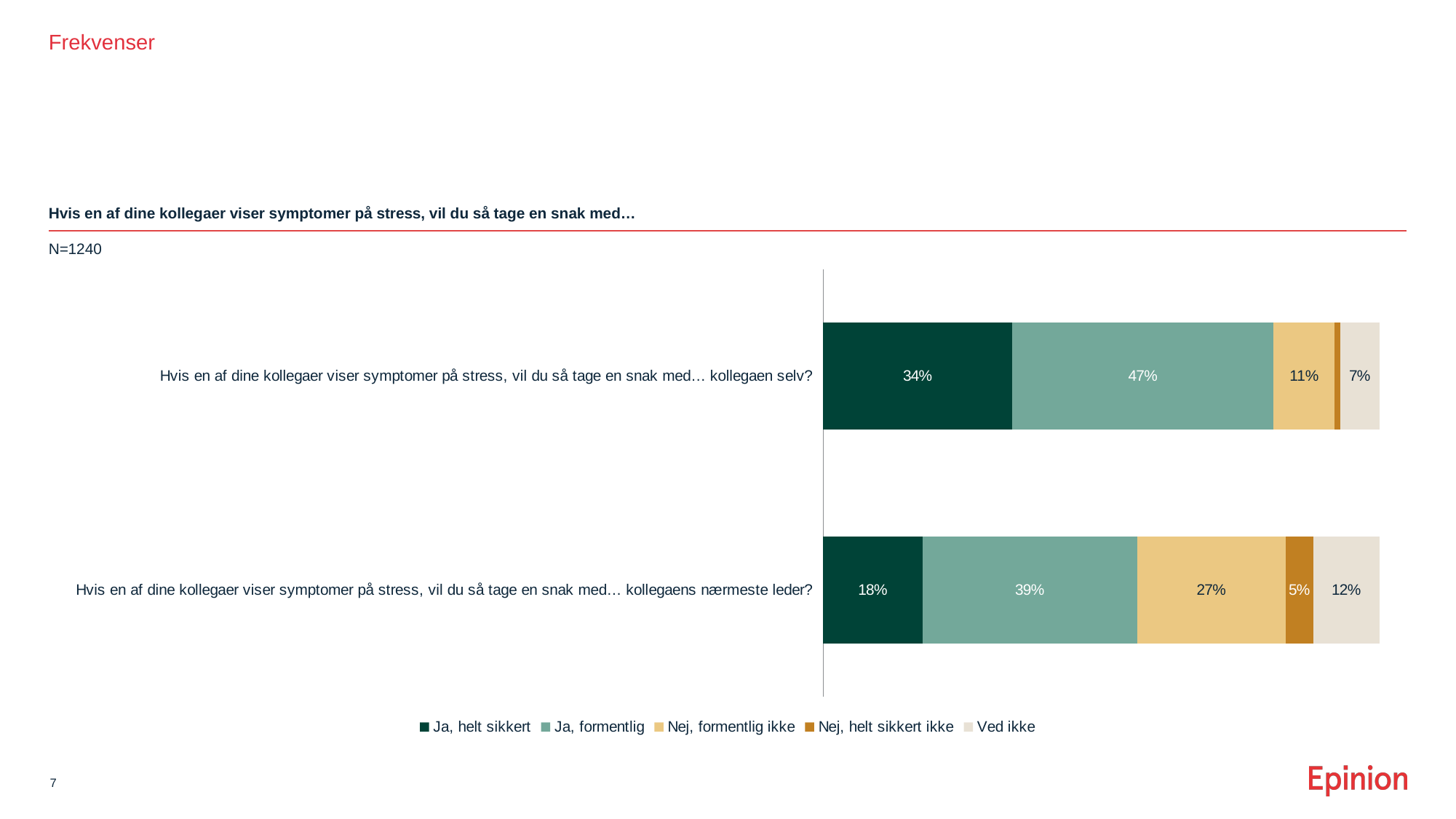
Which labelled segment is the smallest in the bar about the colleague's nearest leader (kollegaens nærmeste leder)? Nej, helt sikkert ikke What share of respondents answered "Ja, helt sikkert" for talking with the colleague themselves (kollegaen selv)? 34% Which of the two bars has the larger "Ja, helt sikkert" share? kollegaen selv What is the "Nej, formentlig ikke" share for the bar about the colleague themselves (kollegaen selv)? 11% What is the difference between the "Nej, formentlig ikke" shares for kollegaens nærmeste leder and kollegaen selv? 16 percentage points What is the "Ved ikke" share for the bar about the colleague's nearest leader (kollegaens nærmeste leder)? 12% How many bars (categories) are shown in the chart? 2 What share of respondents answered "Ja, formentlig" for talking with the colleague's nearest leader (kollegaens nærmeste leder)? 39% Which segment is the largest in the bar about the colleague themselves (kollegaen selv)? Ja, formentlig How many series does the legend list? 5 What kind of chart is shown on the slide? Stacked bar chart What is the difference between the "Ja, formentlig" shares for kollegaen selv and kollegaens nærmeste leder? 8 percentage points